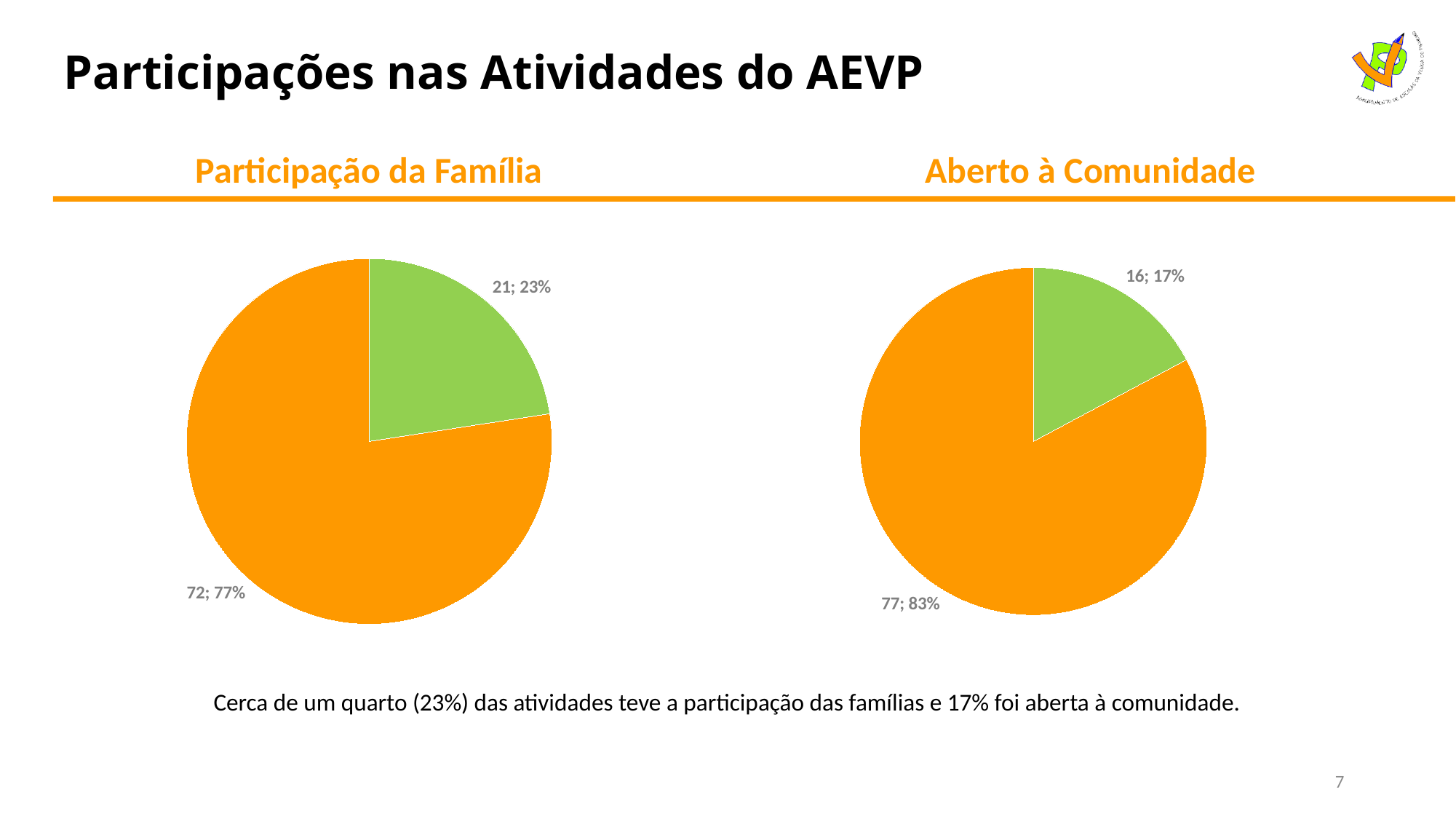
How many slices does the 'Aberto à Comunidade' pie chart have? 2 In the 'Participação da Família' pie chart, what is the data label on the green slice? 21; 23% In the 'Aberto à Comunidade' pie chart, what share of the pie does the orange slice represent? 83% In the 'Aberto à Comunidade' pie chart, what is the data label on the orange slice? 77; 83% In the 'Participação da Família' pie chart, what share of the pie does the green slice represent? 23% What kind of chart is shown under the heading 'Participação da Família'? Pie chart In the 'Aberto à Comunidade' pie chart, what is the data label on the green slice? 16; 17% In the 'Participação da Família' pie chart, what is the data label on the orange slice? 72; 77% In the 'Participação da Família' pie chart, what is the difference between the count of the orange slice and the count of the green slice? 51 Which is larger: the green slice in the 'Participação da Família' chart or the green slice in the 'Aberto à Comunidade' chart? The green slice in 'Participação da Família' (21; 23%) In the 'Participação da Família' pie chart, which slice is the largest? The orange slice (72; 77%) In the 'Aberto à Comunidade' pie chart, which slice is the smallest? The green slice (16; 17%)